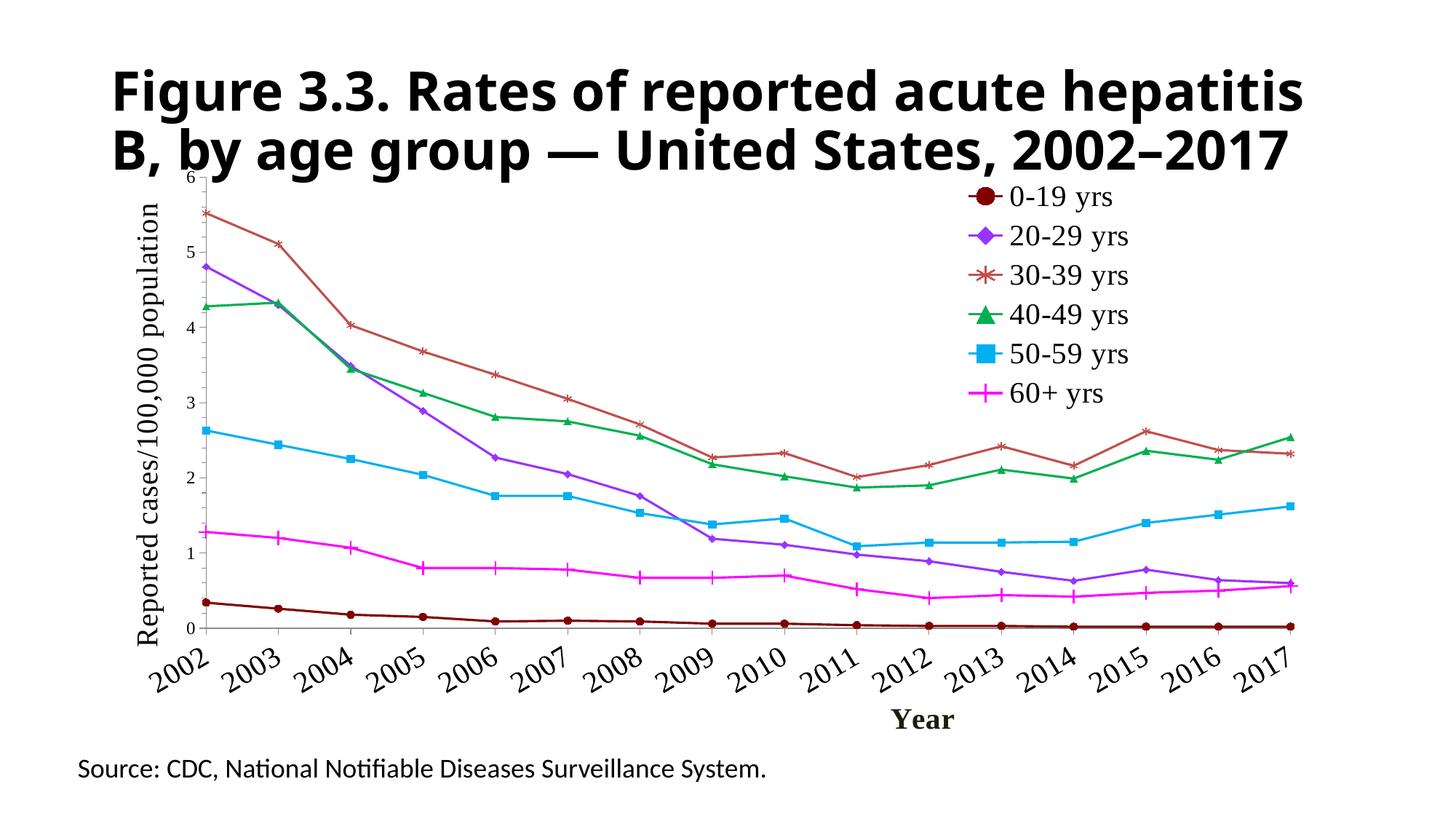
Is the value for 30-39 yrs in 2002 greater or less than 5? greater Is the value for 0-19 yrs in 2002 greater or less than 1? less How many years are plotted along the x axis? 16 What is the title of the y axis? Reported cases/100,000 population Does the rate for 20-29 yrs rise or fall from 2002 to 2017? fall Is the value for 20-29 yrs in 2017 greater or less than 1? less In 2002, which is larger: the rate for 30-39 yrs or the rate for 50-59 yrs? 30-39 yrs How many series does the legend list? 6 What kind of chart is shown on the slide? line chart Which age group has the lowest rate across the whole period? 0-19 yrs Which age group has the highest rate in 2002? 30-39 yrs